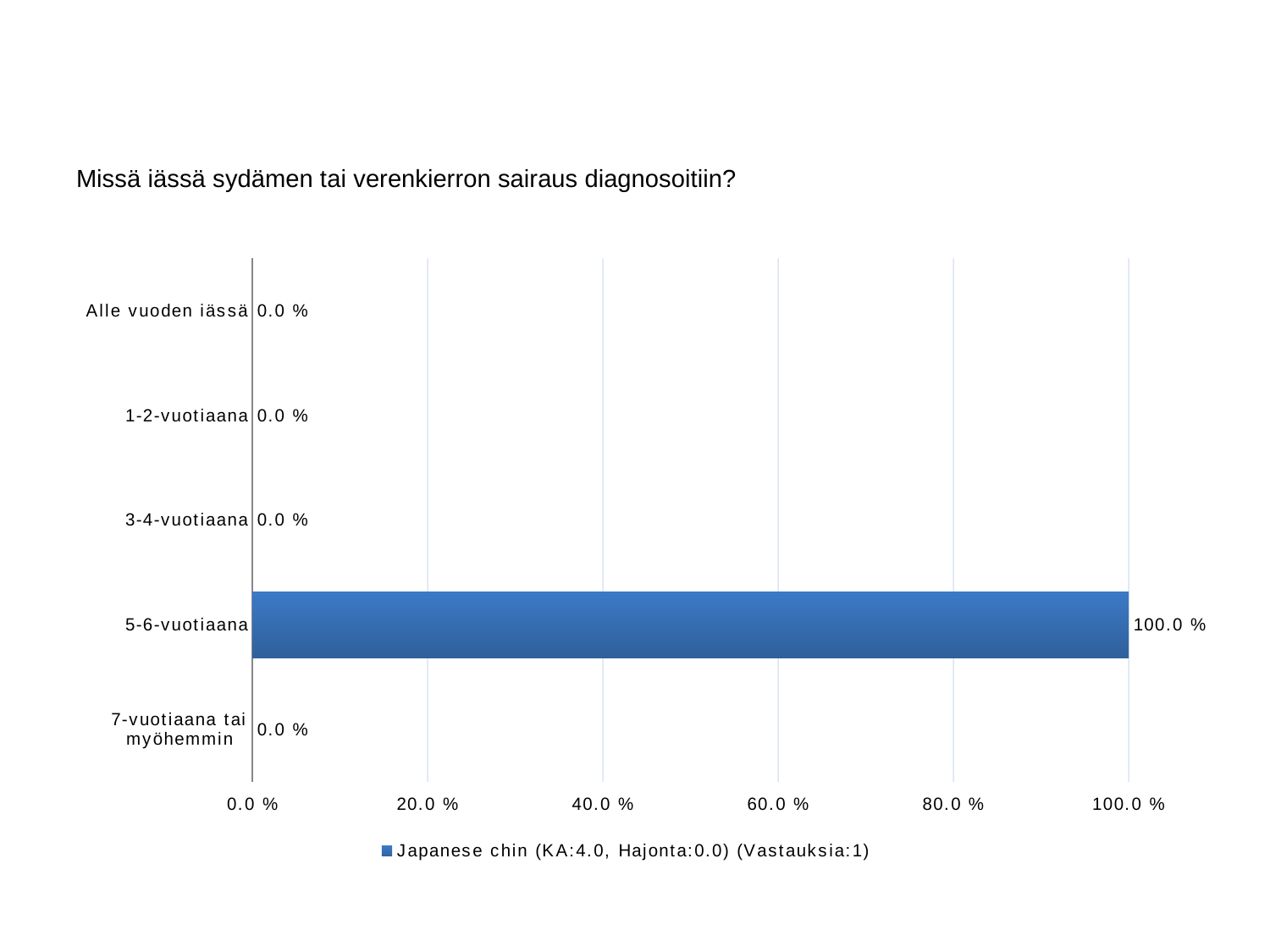
How many categories are shown on the chart? 5 Which is larger, the value for 5-6-vuotiaana or the value for 3-4-vuotiaana? 5-6-vuotiaana What is the value for Alle vuoden iässä? 0.0 % What is the value for 5-6-vuotiaana? 100.0 % What is the title of the chart? Missä iässä sydämen tai verenkierron sairaus diagnosoitiin? How many series does the legend list? 1 What kind of chart is shown on the slide? bar chart What is the difference between the values for 5-6-vuotiaana and 1-2-vuotiaana? 100.0 % Which category has the highest value? 5-6-vuotiaana Is the value for 5-6-vuotiaana greater or less than 80.0 %? greater What is the value for 7-vuotiaana tai myöhemmin? 0.0 % What is the value for 3-4-vuotiaana? 0.0 %